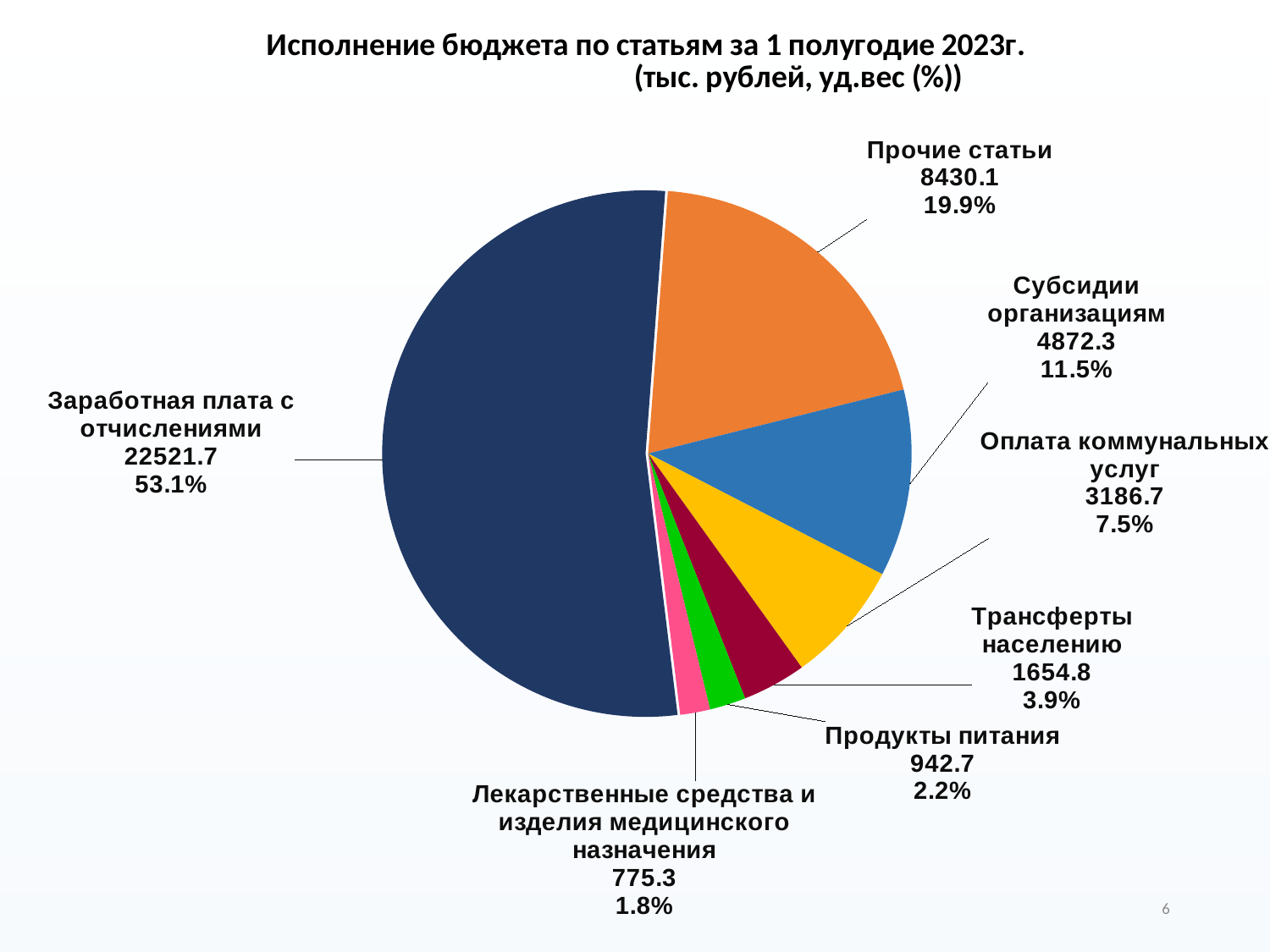
What is the value for Субсидии организациям? 4872.3 What share of the pie does Прочие статьи represent? 19.9% What is the title of the chart? Исполнение бюджета по статьям за 1 полугодие 2023г. (тыс. рублей, уд.вес (%)) What is the difference between the values for Продукты питания and Лекарственные средства и изделия медицинского назначения? 167.4 What is the difference between the values for Прочие статьи and Субсидии организациям? 3557.8 Which category has the largest slice of the pie? Заработная плата с отчислениями What kind of chart is shown on the slide? Pie chart What share of the pie does Оплата коммунальных услуг represent? 7.5% What is the value (тыс. рублей) for Заработная плата с отчислениями? 22521.7 How many slices does the pie chart have? 7 Which category has the smallest slice of the pie? Лекарственные средства и изделия медицинского назначения Which is larger: the value for Трансферты населению or the value for Продукты питания? Трансферты населению